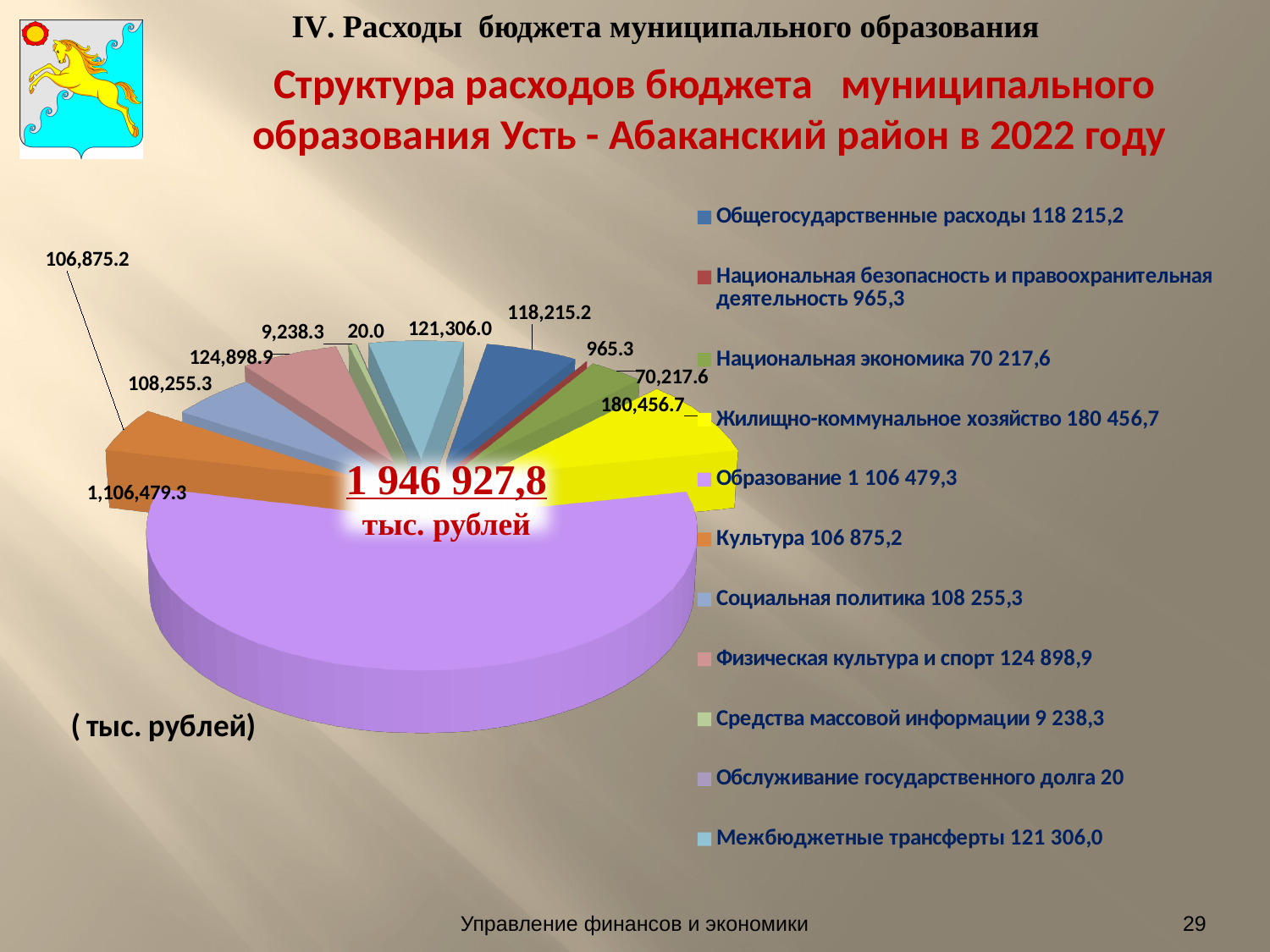
Which category has the smallest value in the pie chart? Обслуживание государственного долга What total amount is printed in the centre of the pie chart? 1 946 927,8 тыс. рублей What colour is the slice for Образование? purple What is the value shown for Жилищно-коммунальное хозяйство? 180,456.7 How many categories (slices) does the pie chart have? 11 What kind of chart is shown on the slide? pie chart What is the value shown for Межбюджетные трансферты? 121,306.0 What is the difference between the values for Жилищно-коммунальное хозяйство and Общегосударственные расходы? 62,241.5 Which category has the largest share of the pie chart? Образование What is the value shown for Средства массовой информации? 9,238.3 Which is larger: the value for Физическая культура и спорт or the value for Социальная политика? Физическая культура и спорт How many entries does the legend list? 11